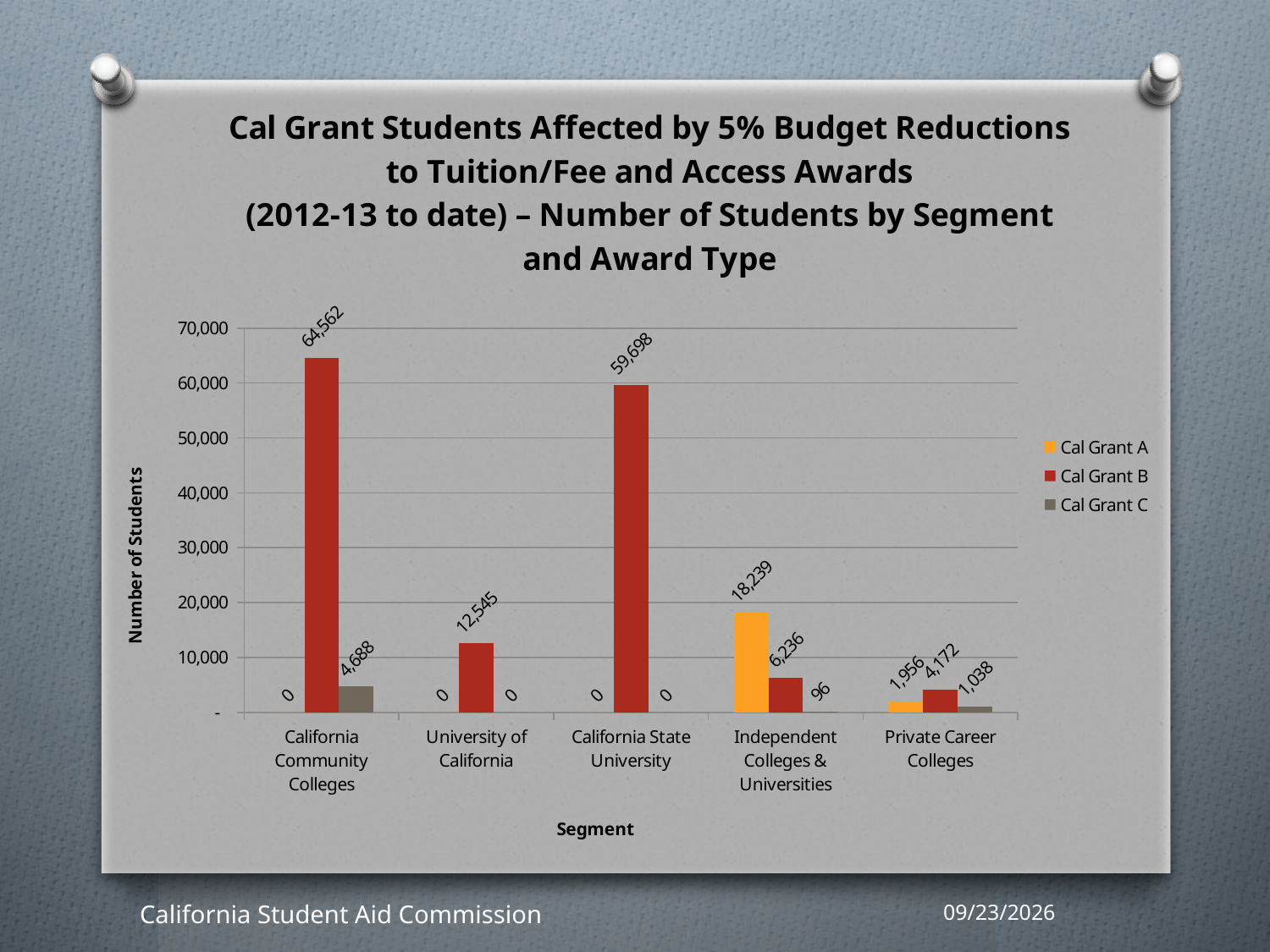
What kind of chart is shown on the slide? Bar chart What is the Cal Grant B value for University of California? 12,545 What is the Cal Grant A value for Independent Colleges & Universities? 18,239 Is the Cal Grant B value for California State University greater or less than 50,000? greater How many series does the legend list? 3 What is the difference between the Cal Grant B values for California Community Colleges and California State University? 4,864 For Private Career Colleges, which is larger: Cal Grant A or Cal Grant B? Cal Grant B What is the Cal Grant C value for Private Career Colleges? 1,038 What is the Cal Grant B value for California Community Colleges? 64,562 Which segment has the highest Cal Grant B value? California Community Colleges Which segment has the lowest non-zero Cal Grant C value? Independent Colleges & Universities How many segments are shown on the x axis? 5